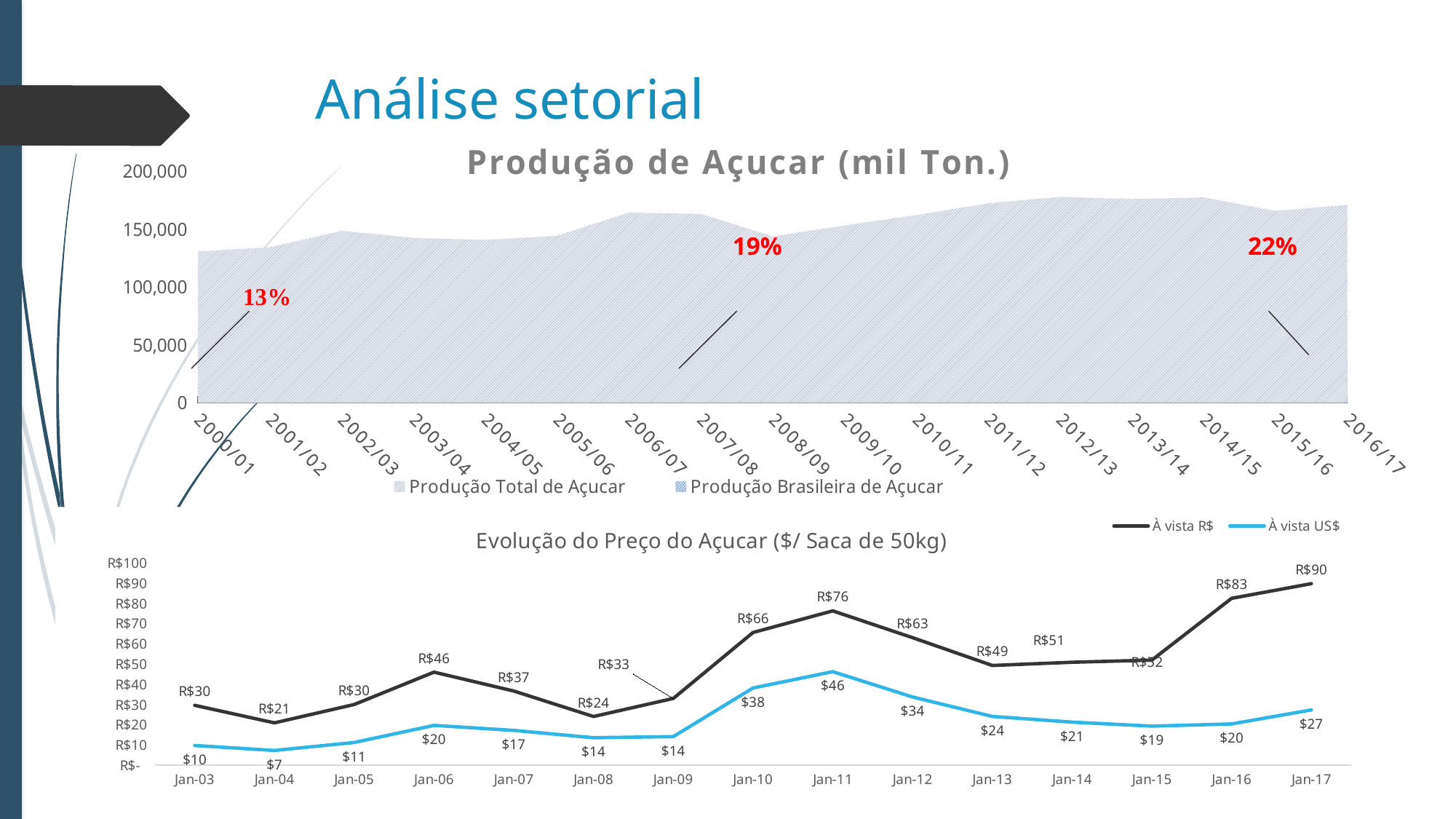
In the chart titled 'Evolução do Preço do Açucar ($/ Saca de 50kg)', at which date does the 'À vista R$' series reach its highest value? Jan-17 In the chart titled 'Evolução do Preço do Açucar ($/ Saca de 50kg)', how many dates are shown on the x axis? 15 In the chart titled 'Evolução do Preço do Açucar ($/ Saca de 50kg)', what is the difference between the 'À vista R$' values at Jan-17 and Jan-16? R$7 In the chart titled 'Produção de Açucar (mil Ton.)', is the value for 2016/17 greater or less than 150,000? greater In the chart titled 'Evolução do Preço do Açucar ($/ Saca de 50kg)', which is larger for the 'À vista US$' series: Jan-10 or Jan-12? Jan-10 In the chart titled 'Evolução do Preço do Açucar ($/ Saca de 50kg)', at which date is the 'À vista US$' series lowest? Jan-04 In the chart titled 'Evolução do Preço do Açucar ($/ Saca de 50kg)', what is the value of the 'À vista US$' series at Jan-04? $7 What kind of chart is 'Evolução do Preço do Açucar ($/ Saca de 50kg)'? Line chart In the chart titled 'Produção de Açucar (mil Ton.)', what are the two legend entries? Produção Total de Açucar; Produção Brasileira de Açucar In the chart titled 'Produção de Açucar (mil Ton.)', how many seasons are shown on the x axis? 17 In the chart titled 'Evolução do Preço do Açucar ($/ Saca de 50kg)', how many series does the legend list? 2 In the chart titled 'Evolução do Preço do Açucar ($/ Saca de 50kg)', what is the value of the 'À vista R$' series at Jan-11? R$76